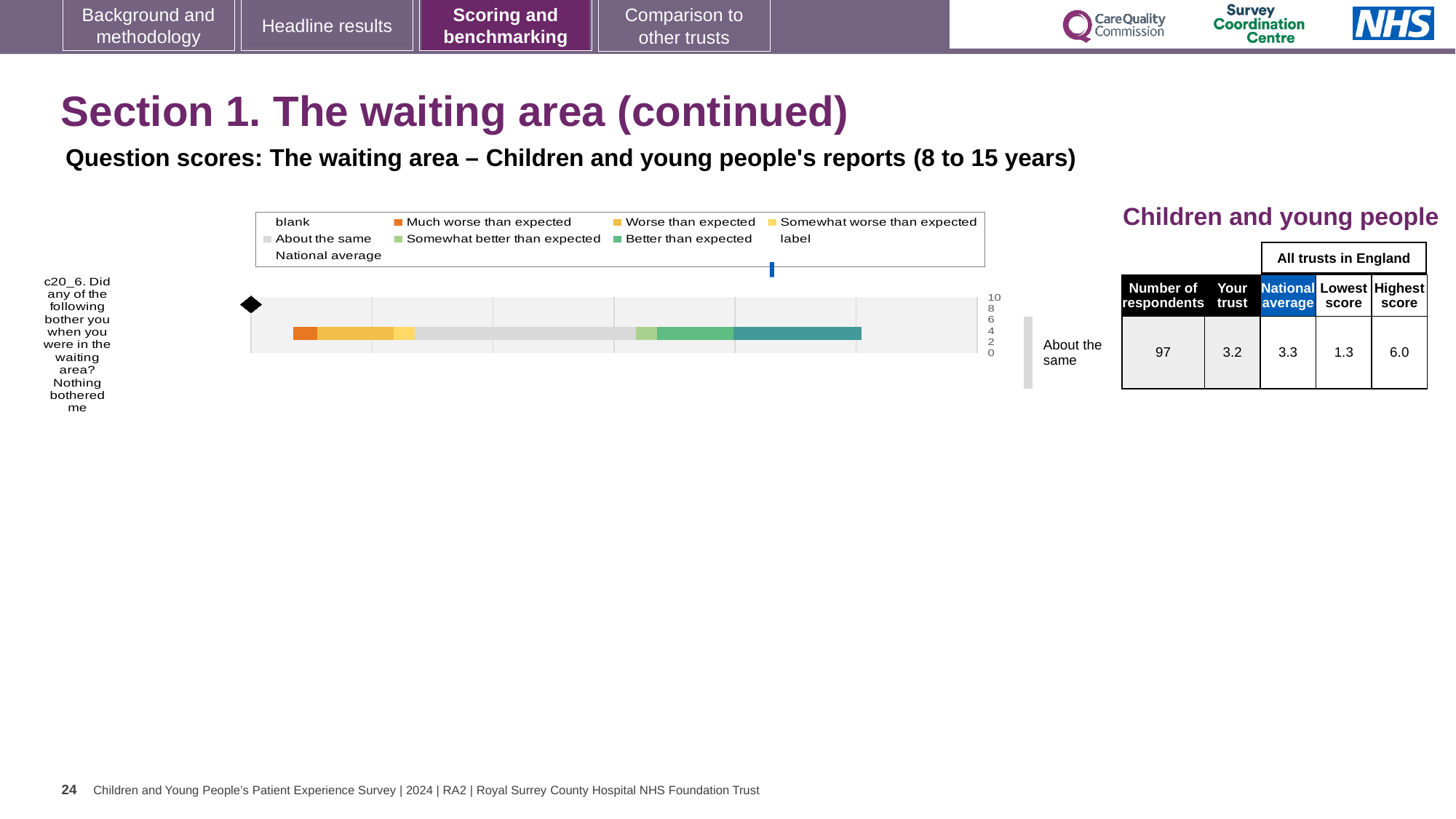
What is the difference between the highest score and the lowest score for question c20_6? 4.7 What is the highest value shown on the chart's score axis? 10 Which is larger for question c20_6, the 'Your trust' score or the national average? National average How many respondents are reported for question c20_6? 97 What kind of chart is used to show the question score for c20_6? bar chart How many survey questions are plotted on the chart? 1 What is the lowest score among all trusts in England for question c20_6? 1.3 What is the national average score for question c20_6? 3.3 What is the 'Your trust' score for question c20_6? 3.2 What benchmark category label is shown to the right of the chart for question c20_6? About the same What is the question code of the item plotted on the chart? c20_6 What is the highest score among all trusts in England for question c20_6? 6.0